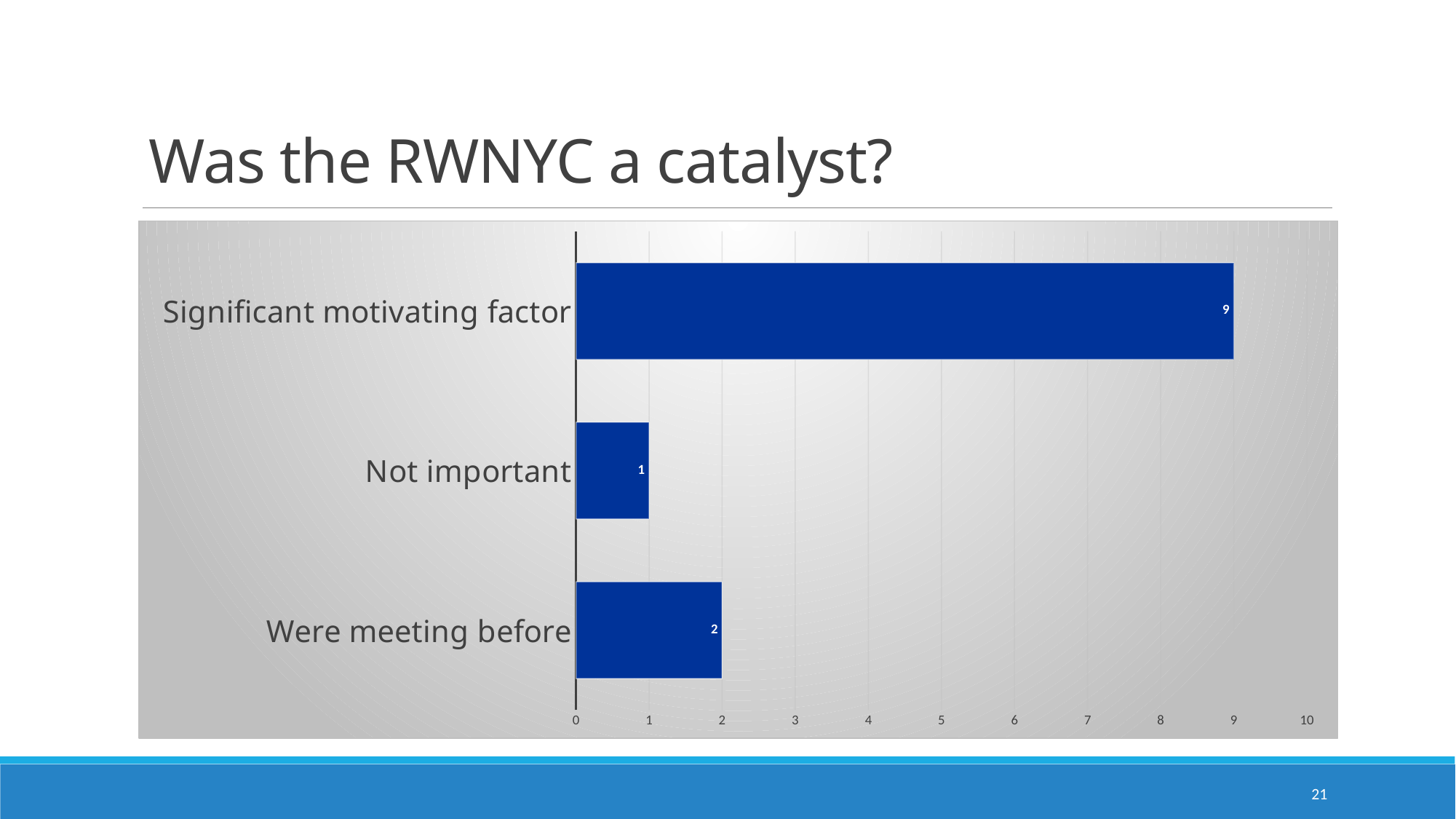
How many categories are shown in the chart? 3 Which category has the lowest value? Not important What kind of chart is shown on the slide? bar chart Which is larger, the value for Were meeting before or the value for Not important? Were meeting before Which category has the highest value? Significant motivating factor What is the value for Were meeting before? 2 What is the value for Not important? 1 What is the difference between the values for Significant motivating factor and Were meeting before? 7 Is the value for Significant motivating factor greater or less than 5? greater What is the value for Significant motivating factor? 9 What is the title of the slide containing the chart? Was the RWNYC a catalyst? What is the difference between the values for Were meeting before and Not important? 1